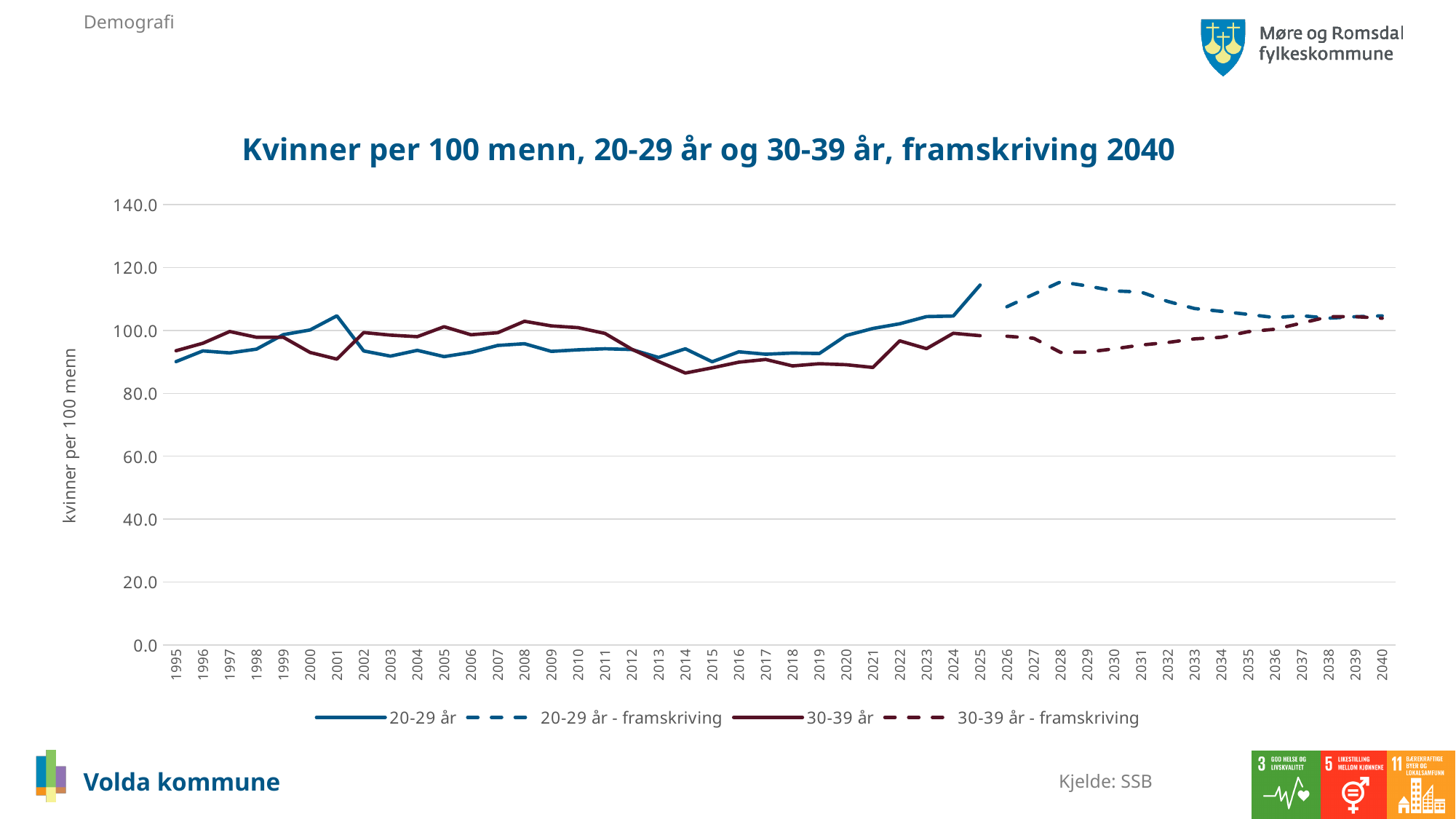
In 2014, which series has the larger value, 20-29 år or 30-39 år? 20-29 år Is the value for 20-29 år - framskriving in 2028 greater or less than 100? greater Is the value for 30-39 år in 2014 greater or less than 100? less What is the label on the vertical axis? kvinner per 100 menn What kind of chart is shown on the slide? line chart In which year does the 20-29 år series reach its highest value? 2025 Does the 20-29 år - framskriving series rise or fall from 2028 to 2040? fall How many series does the legend list? 4 In 2008, which series has the larger value, 20-29 år or 30-39 år? 30-39 år How many years are shown along the x axis, from 1995 to 2040? 46 Is the value for 20-29 år in 2025 greater or less than 100? greater What is the title of the chart? Kvinner per 100 menn, 20-29 år og 30-39 år, framskriving 2040